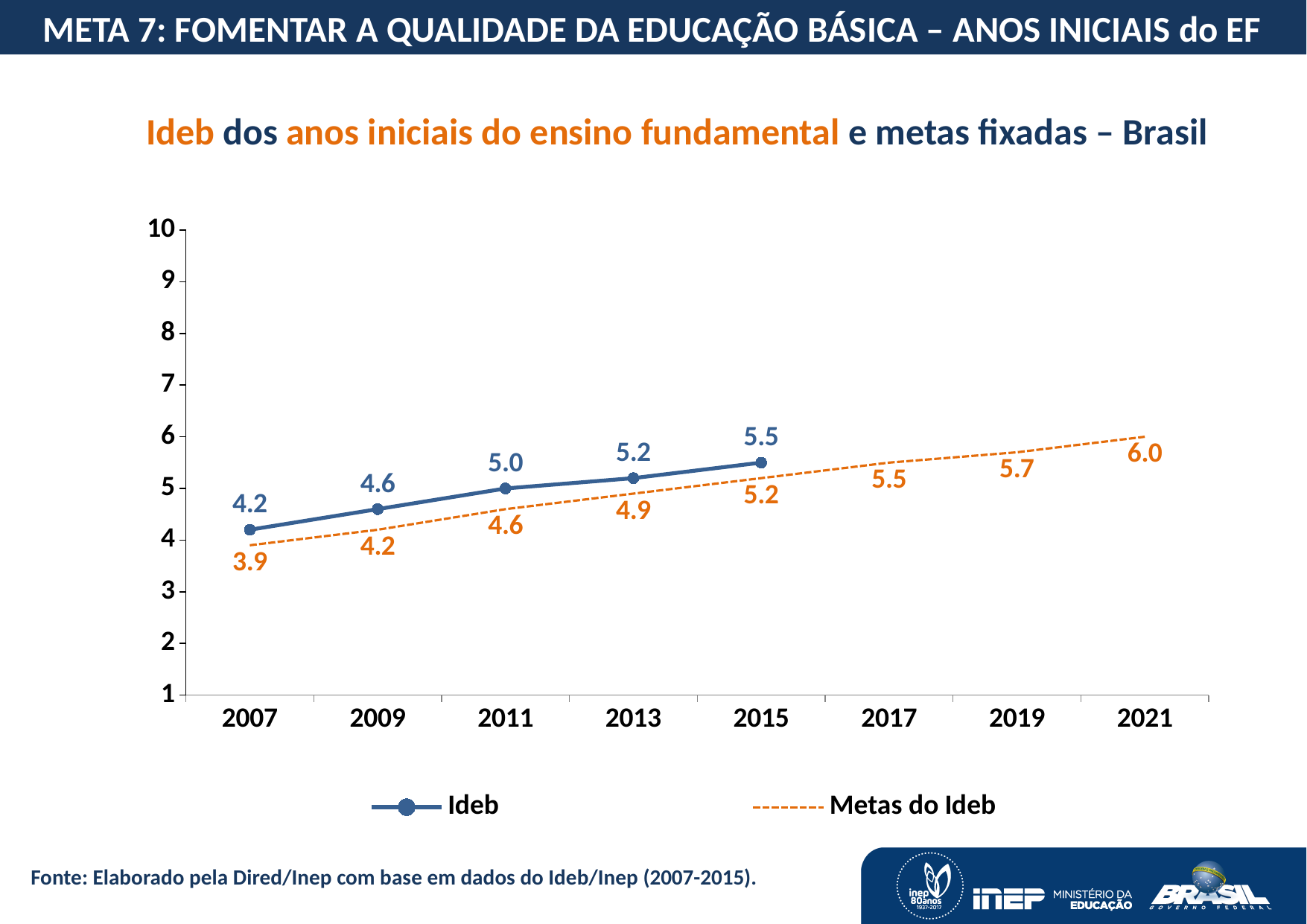
In which year is the Ideb series at its highest? 2015 What is the Ideb value for 2011? 5.0 What is the Metas do Ideb value for 2021? 6.0 What is the difference between the Ideb value and the Metas do Ideb value in 2013? 0.3 Does the Metas do Ideb series rise or fall from 2007 to 2021? Rises In which year is the Metas do Ideb series at its lowest? 2007 How many years are labelled on the x axis? 8 What is the Ideb value for 2015? 5.5 What is the Metas do Ideb value for 2007? 3.9 In 2009, which is larger: the Ideb value or the Metas do Ideb value? Ideb How many series does the legend list? 2 What kind of chart is shown on the slide? Line chart